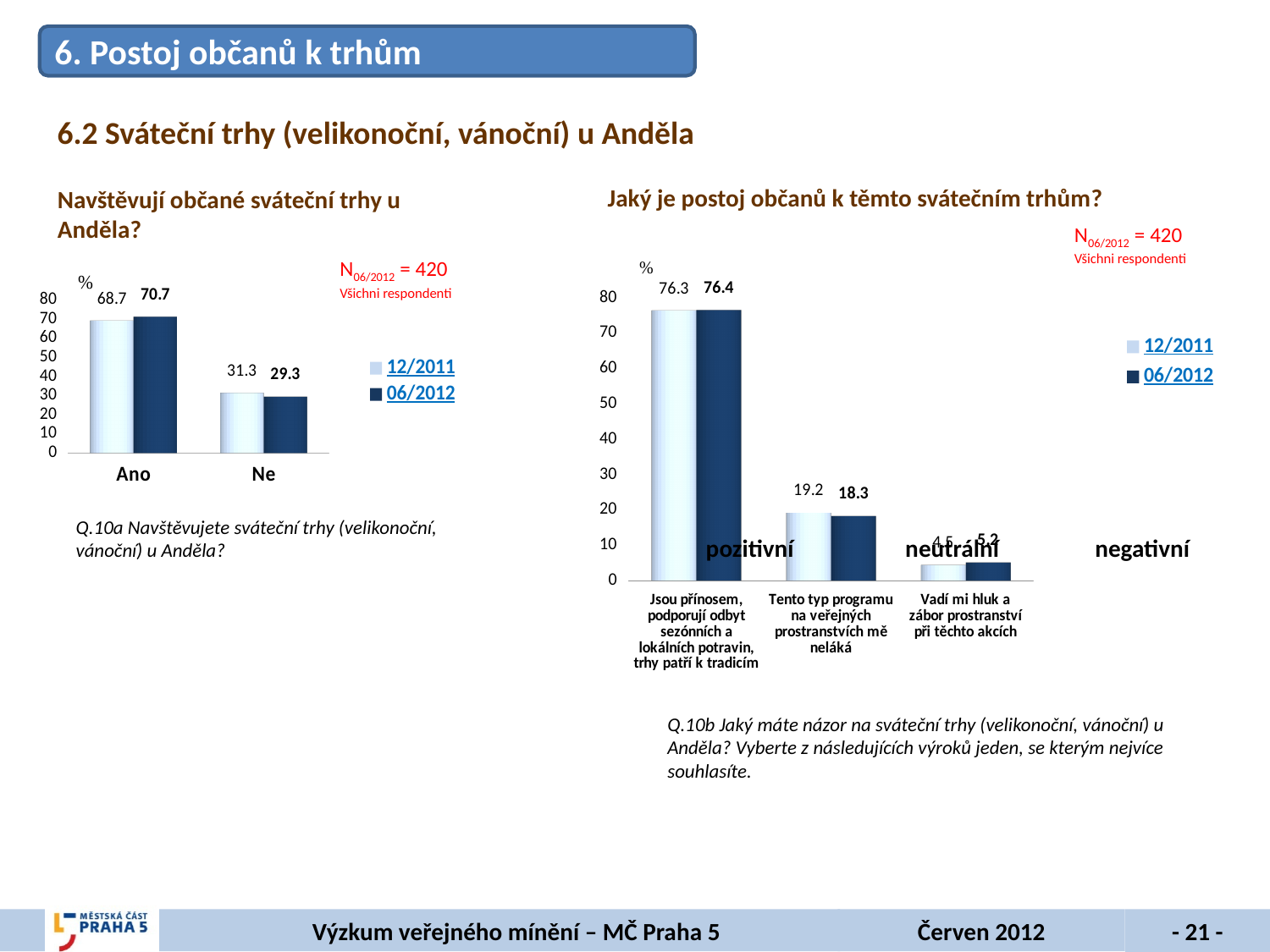
What kind of chart is the right chart (Jaký je postoj občanů k těmto svátečním trhům?)? bar chart In the right chart (Jaký je postoj občanů k těmto svátečním trhům?), what is the 12/2011 value for 'Tento typ programu na veřejných prostranstvích mě neláká'? 19.2 In the left chart (Navštěvují občané sváteční trhy u Anděla?), what is the value for Ano in 06/2012? 70.7 In the left chart (Navštěvují občané sváteční trhy u Anděla?), what is the difference between the 06/2012 values for Ano and Ne? 41.4 In the right chart (Jaký je postoj občanů k těmto svátečním trhům?), how many categories are shown on the x axis? 3 In the right chart (Jaký je postoj občanů k těmto svátečním trhům?), what is the 06/2012 value for 'Jsou přínosem, podporují odbyt sezónních a lokálních potravin, trhy patří k tradicím'? 76.4 In the left chart (Navštěvují občané sváteční trhy u Anděla?), what is the value for Ne in 12/2011? 31.3 In the right chart (Jaký je postoj občanů k těmto svátečním trhům?), is the 06/2012 value for 'Vadí mi hluk a zábor prostranství při těchto akcích' greater or less than 10? less In the left chart (Navštěvují občané sváteční trhy u Anděla?), did the value for Ano rise or fall from 12/2011 to 06/2012? rise In the left chart (Navštěvují občané sváteční trhy u Anděla?), how many series does the legend list? 2 In the right chart (Jaký je postoj občanů k těmto svátečním trhům?), which category has the lowest value in 12/2011? Vadí mi hluk a zábor prostranství při těchto akcích In the right chart (Jaký je postoj občanů k těmto svátečním trhům?), which category has the highest value in 06/2012? Jsou přínosem, podporují odbyt sezónních a lokálních potravin, trhy patří k tradicím